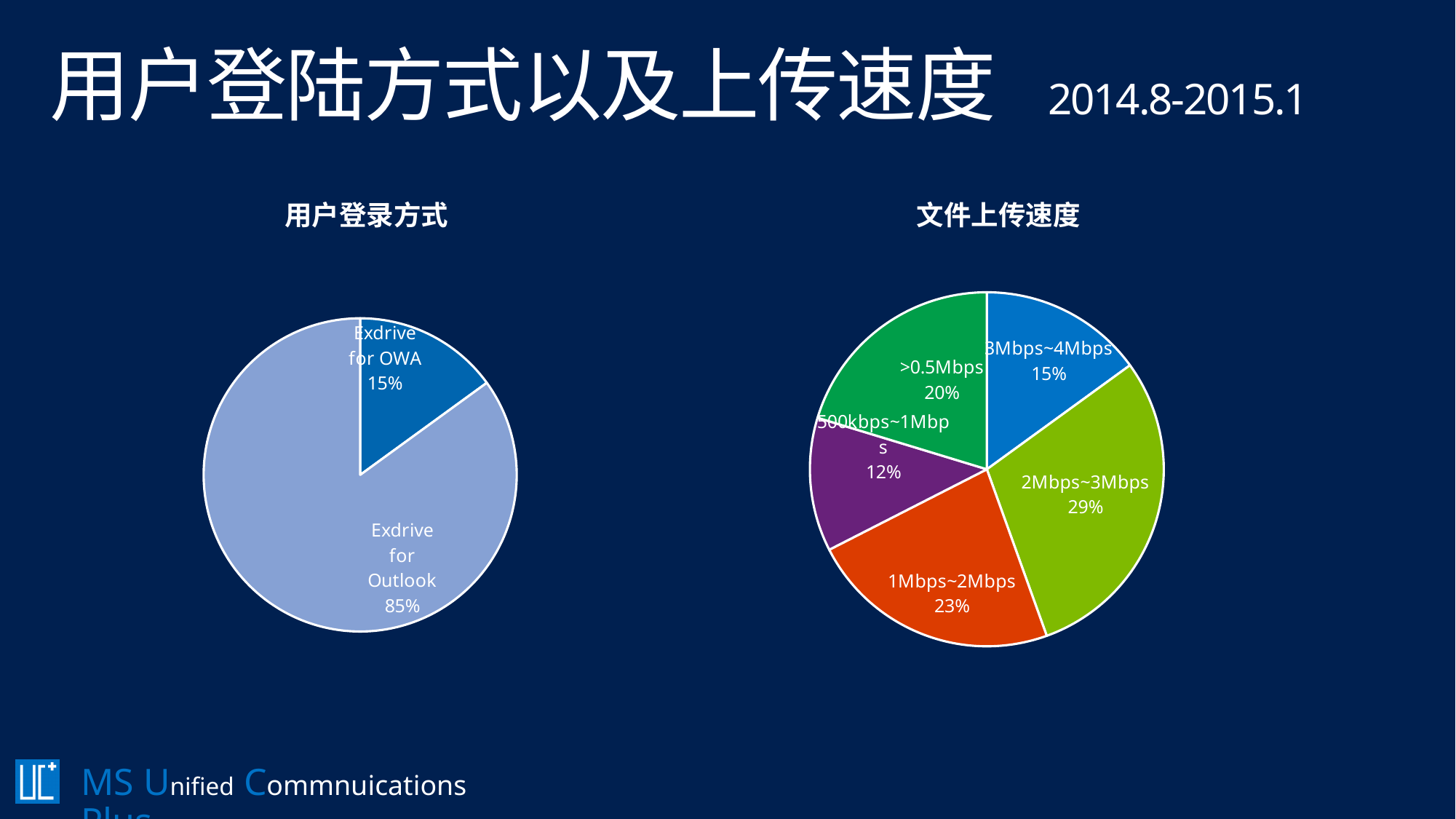
In the 文件上传速度 chart, which speed range has the largest share? 2Mbps~3Mbps In the 用户登录方式 chart, what is the difference between the Exdrive for Outlook and Exdrive for OWA shares? 70% In the 用户登录方式 chart, what share is Exdrive for Outlook? 85% In the 文件上传速度 chart, which is larger: the share for >0.5Mbps or the share for 3Mbps~4Mbps? >0.5Mbps In the 用户登录方式 chart, what share is Exdrive for OWA? 15% In the 文件上传速度 chart, which speed range has the smallest share? 500kbps~1Mbps In the 文件上传速度 chart, how many slices are there? 5 In the 文件上传速度 chart, what share is 1Mbps~2Mbps? 23% What kind of chart is the 用户登录方式 chart? Pie chart In the 用户登录方式 chart, which login method has the larger share? Exdrive for Outlook In the 文件上传速度 chart, what is the difference between the 2Mbps~3Mbps share and the 1Mbps~2Mbps share? 6%